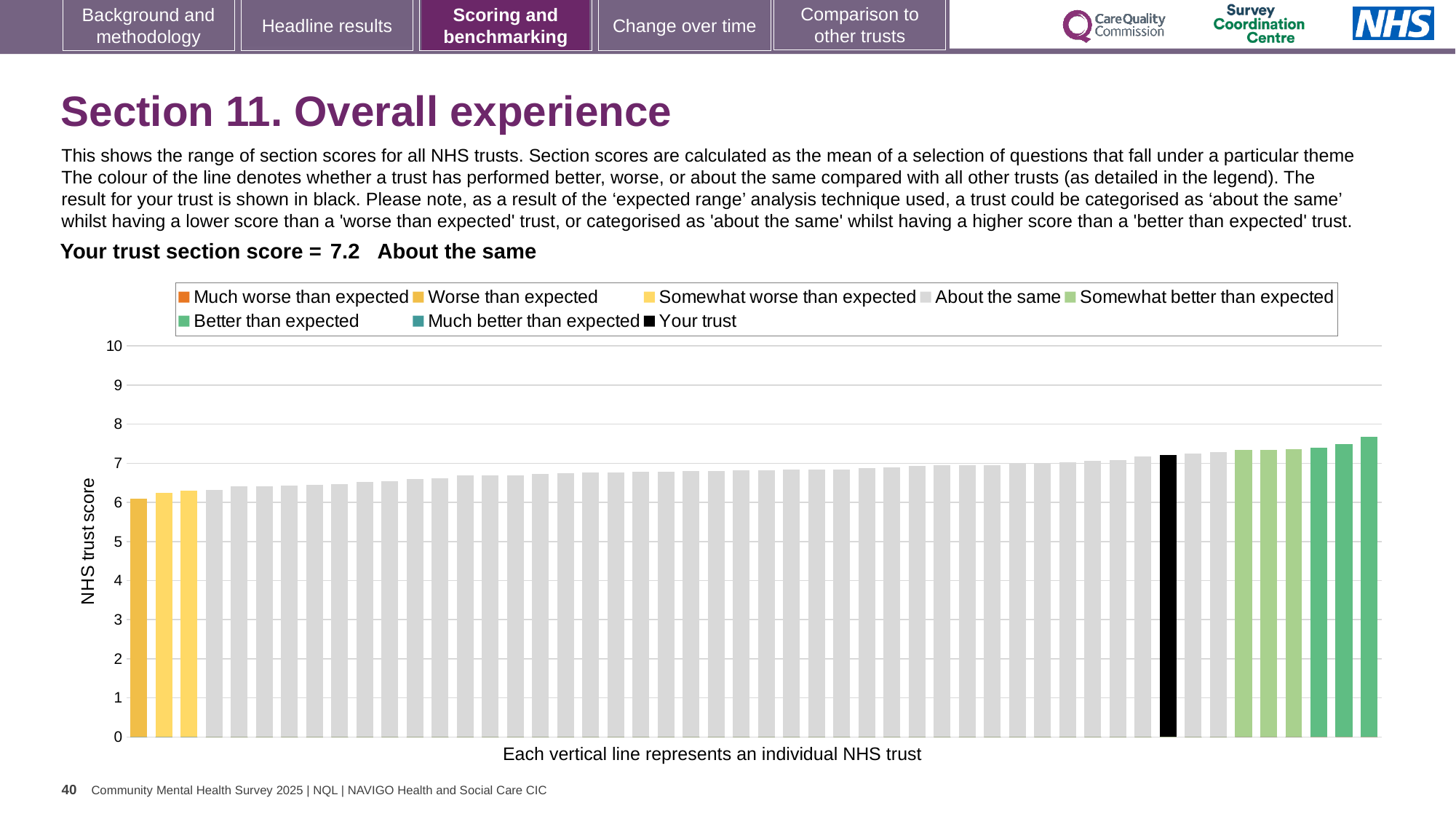
Is the value of the black 'Your trust' bar greater or less than 7? greater What kind of chart is shown on the slide? bar chart According to the legend, what colour represents 'Your trust'? black How many entries does the chart legend list? 8 Is the value of the rightmost (highest) bar greater or less than 8? less What is the label on the vertical axis of the chart? NHS trust score Is the value of the leftmost (lowest) bar greater or less than 7? less What is the section score for your trust (the black bar)? 7.2 Which is larger: the rightmost bar or the black 'Your trust' bar? the rightmost bar Do the bar values rise or fall from left to right across the chart? rise Which is larger: the black 'Your trust' bar or the leftmost bar? the black 'Your trust' bar